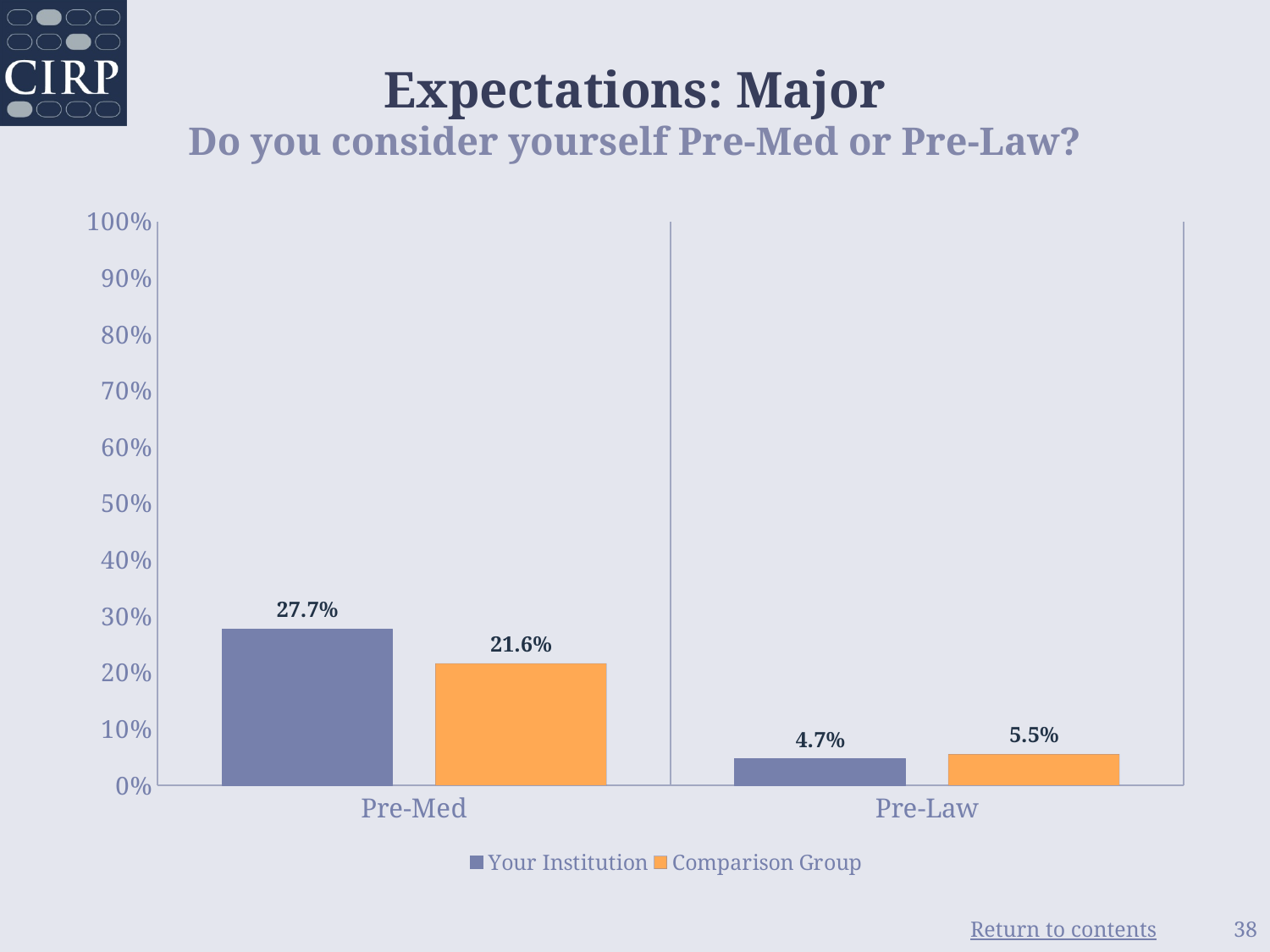
What kind of chart is shown on the slide? Bar chart What percentage of Your Institution students consider themselves Pre-Med? 27.7% Which category has the highest value for Your Institution? Pre-Med What is the Comparison Group value for Pre-Law? 5.5% For Pre-Law, which is larger: Your Institution or the Comparison Group? Comparison Group How many categories are shown on the x axis? 2 What is the Your Institution value for Pre-Law? 4.7% What is the difference between Your Institution and the Comparison Group for Pre-Med? 6.1% How many series does the legend list? 2 What is the difference between the Comparison Group and Your Institution for Pre-Law? 0.8% What is the Comparison Group value for Pre-Med? 21.6% Which category has the lowest value for the Comparison Group? Pre-Law